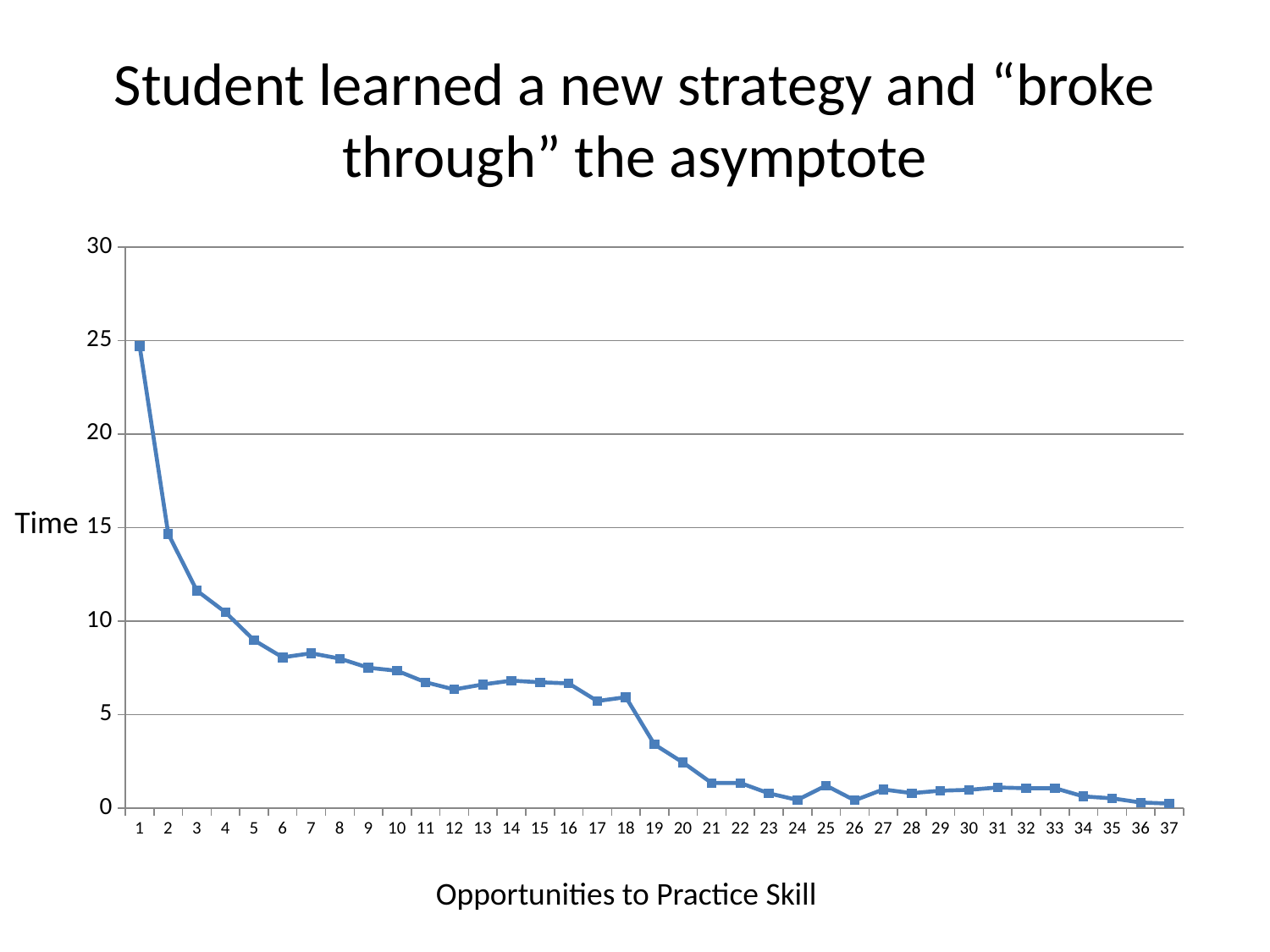
Is the Time value at opportunity 6 greater or less than 10? less At which opportunity number is the Time value highest? 1 What is the label on the x axis of the chart? Opportunities to Practice Skill Which has the larger Time value, opportunity 1 or opportunity 2? opportunity 1 Is the Time value at opportunity 1 greater or less than 20? greater Is the Time value at opportunity 3 greater or less than 10? greater What kind of chart is shown on the slide? line chart Which has the larger Time value, opportunity 5 or opportunity 20? opportunity 5 Do the Time values generally rise or fall as the number of opportunities to practice increases? fall How many opportunities to practice the skill are plotted along the x axis? 37